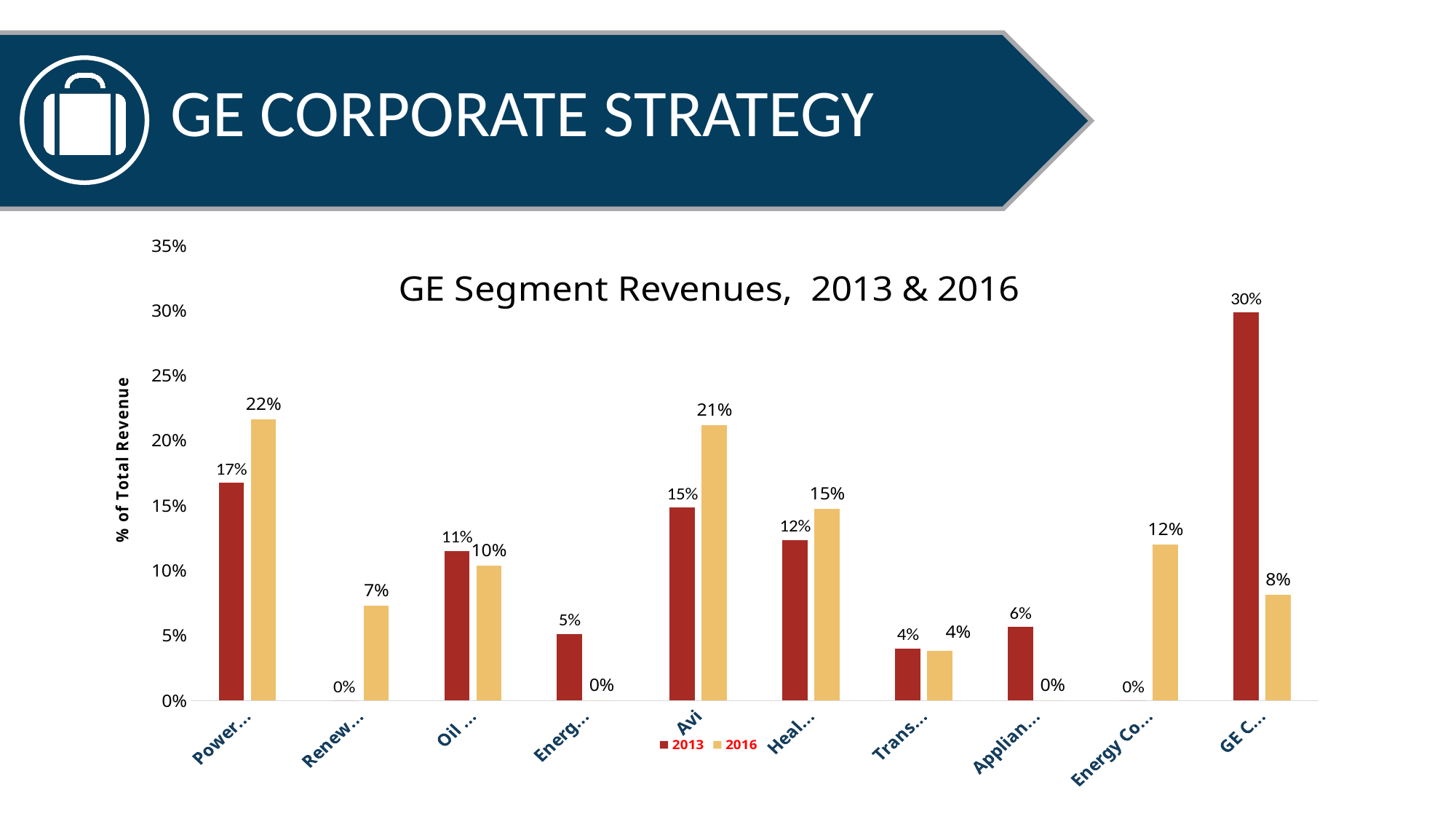
How many categories are plotted along the x axis of the chart? 10 Which category has the highest 2016 value? Power… For the category labelled 'Heal…', which is larger, the 2013 value or the 2016 value? 2016 What is the 2016 value for the first category (labelled 'Power…')? 22% What is the 2013 value for the last category (labelled 'GE C…')? 30% What is the 2016 value for the category labelled 'Energy Co…'? 12% What kind of chart is shown on the slide? bar chart What is the difference between the 2013 and 2016 values for the last category (labelled 'GE C…')? 22% What is the title of the chart? GE Segment Revenues, 2013 & 2016 Which category has the highest 2013 value? GE C… What is the 2016 value for the category labelled 'Avi'? 21% How many series does the chart's legend list? 2